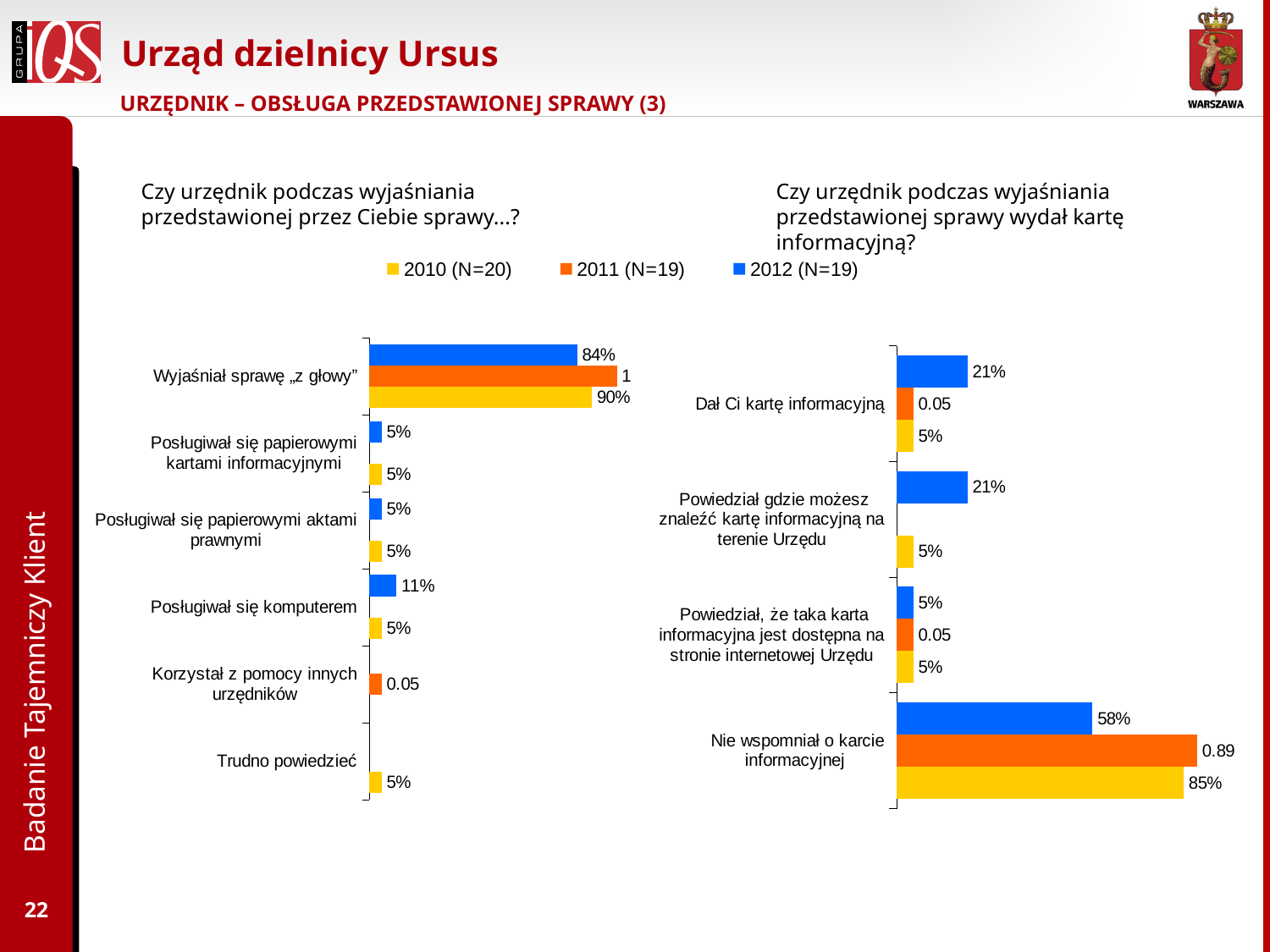
In the right chart, which is larger for "Nie wspomniał o karcie informacyjnej": the 2010 (N=20) value or the 2012 (N=19) value? 2010 (N=20) In the left chart ("Czy urzędnik podczas wyjaśniania przedstawionej przez Ciebie sprawy...?"), what is the 2012 (N=19) value for "Wyjaśniał sprawę „z głowy”"? 84% In the left chart, what is the 2010 (N=20) value for "Wyjaśniał sprawę „z głowy”"? 90% How many series does the legend list for the charts on this slide? 3 In the left chart, how many categories are listed on the vertical axis? 6 In the right chart, what is the 2011 (N=19) value for "Nie wspomniał o karcie informacyjnej"? 0.89 In the right chart, what is the 2012 (N=19) value for "Dał Ci kartę informacyjną"? 21% In the left chart, what is the 2012 (N=19) value for "Posługiwał się komputerem"? 11% In the right chart, which category has the highest 2010 (N=20) value? Nie wspomniał o karcie informacyjnej In the left chart, what is the difference between the 2010 (N=20) and 2012 (N=19) values for "Wyjaśniał sprawę „z głowy”"? 6 percentage points In the left chart, what is the 2011 (N=19) value for "Korzystał z pomocy innych urzędników"? 0.05 In the right chart ("Czy urzędnik podczas wyjaśniania przedstawionej sprawy wydał kartę informacyjną?"), what is the 2012 (N=19) value for "Nie wspomniał o karcie informacyjnej"? 58%